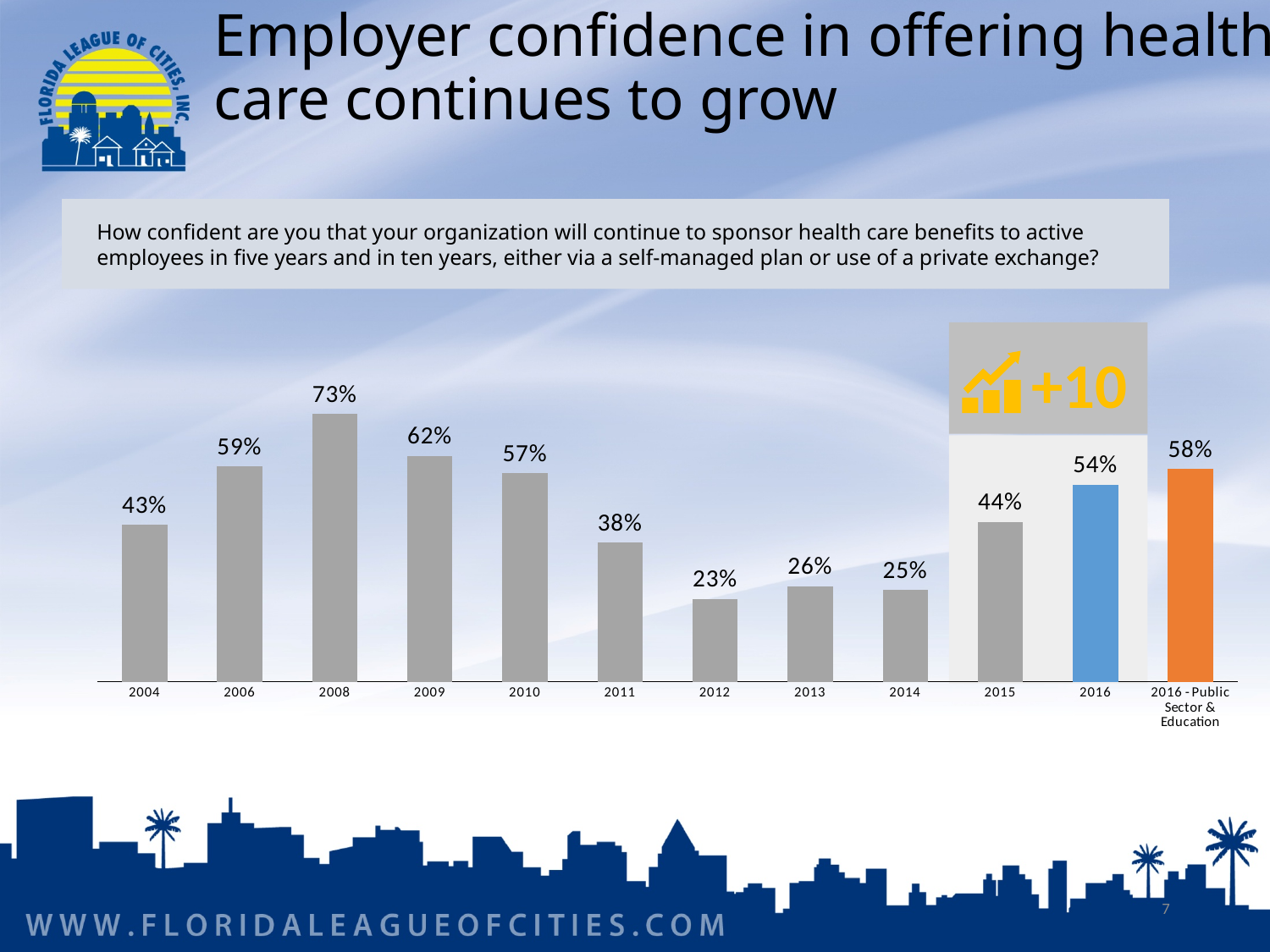
What is the value for 2016? 54% What kind of chart is shown on the slide? Bar chart What is the value for 2012? 23% Which year has the highest value? 2008 Which category has the lowest value? 2012 What is the value for 2008? 73% Which is larger, the value for 2009 or the value for 2010? 2009 How many bars are shown in the chart? 12 Do the values rise or fall from 2012 to 2016? Rise What is the value for 2016 - Public Sector & Education? 58% What is the difference between the values for 2016 and 2015? 10% What colour is the bar for 2016 - Public Sector & Education? Orange